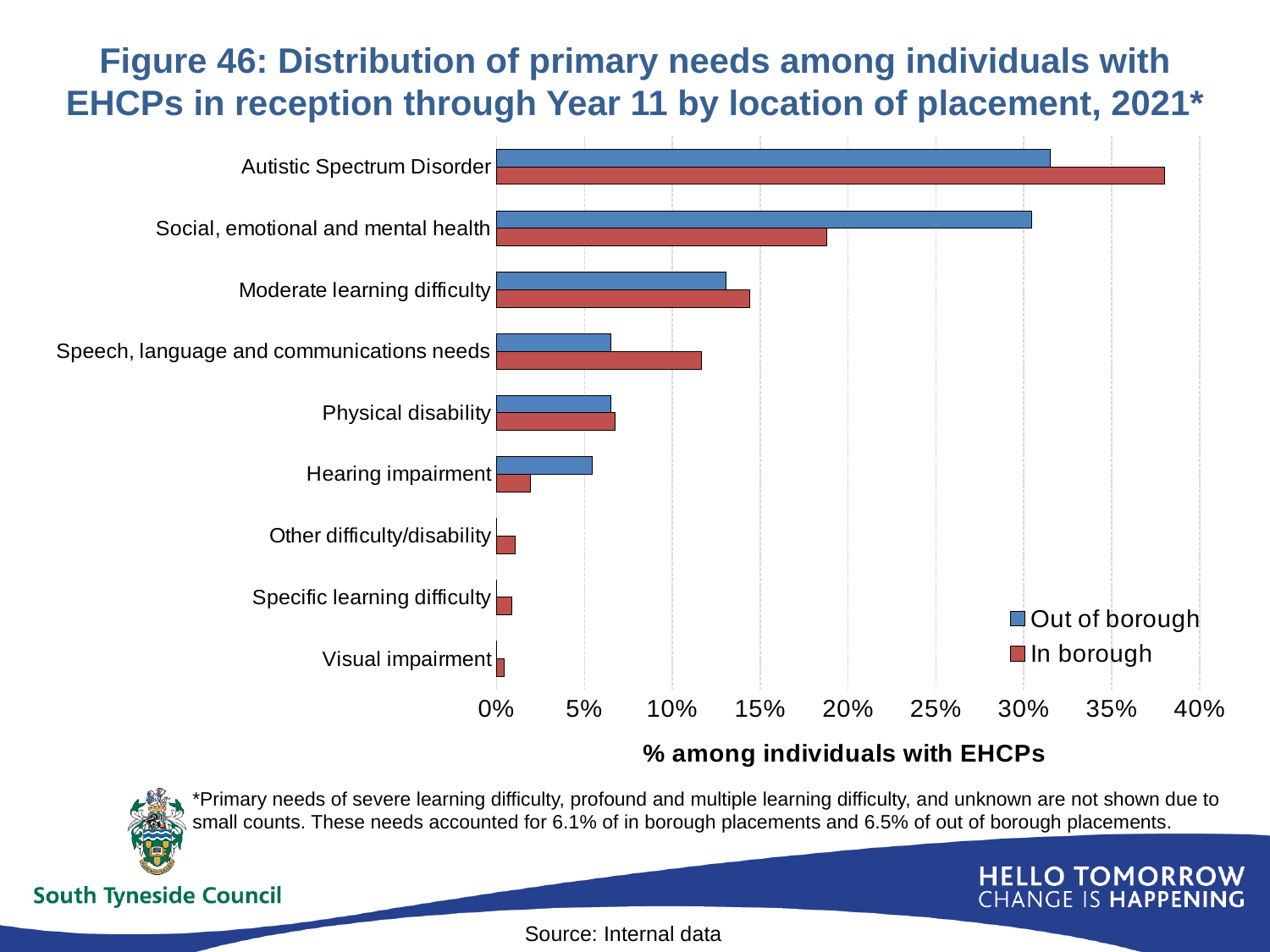
Is the In borough value for Hearing impairment greater or less than 5%? less Which primary need has the lowest In borough value? Visual impairment What is the title of the horizontal axis? % among individuals with EHCPs How many primary need categories are plotted on the chart? 9 For Social, emotional and mental health, which is larger: the Out of borough value or the In borough value? Out of borough Is the In borough value for Speech, language and communications needs greater or less than 10%? greater Is the In borough value for Autistic Spectrum Disorder greater or less than 35%? greater Which primary need has the highest In borough value? Autistic Spectrum Disorder What kind of chart is shown on the slide? Bar chart How many series does the legend list? 2 For Autistic Spectrum Disorder, which is larger: the In borough value or the Out of borough value? In borough